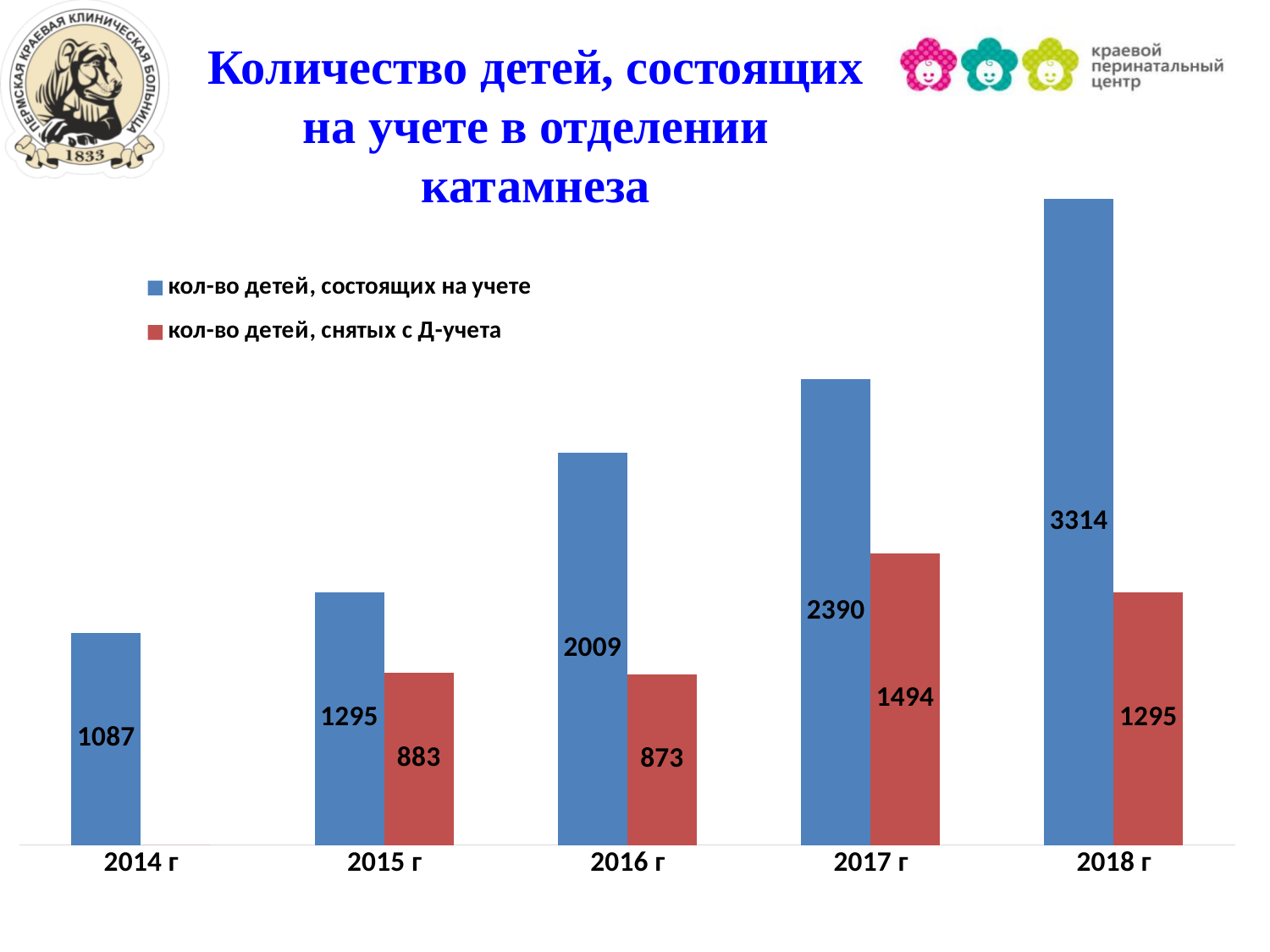
What is the difference between 'кол-во детей, состоящих на учете' and 'кол-во детей, снятых с Д-учета' in 2018 г? 2019 Does 'кол-во детей, состоящих на учете' rise or fall from 2014 г to 2018 г? Rise How many series does the legend list? 2 Which year has the lowest value for 'кол-во детей, снятых с Д-учета' among the years where it is shown? 2016 г How many years are shown on the x axis? 5 What is the difference between 'кол-во детей, состоящих на учете' in 2017 г and in 2016 г? 381 What is the value for 'кол-во детей, состоящих на учете' in 2016 г? 2009 Which year has the highest value for 'кол-во детей, состоящих на учете'? 2018 г What is the value for 'кол-во детей, состоящих на учете' in 2014 г? 1087 Which is larger: 'кол-во детей, снятых с Д-учета' in 2017 г or in 2018 г? 2017 г What is the value for 'кол-во детей, снятых с Д-учета' in 2017 г? 1494 What kind of chart is shown on the slide? Bar chart